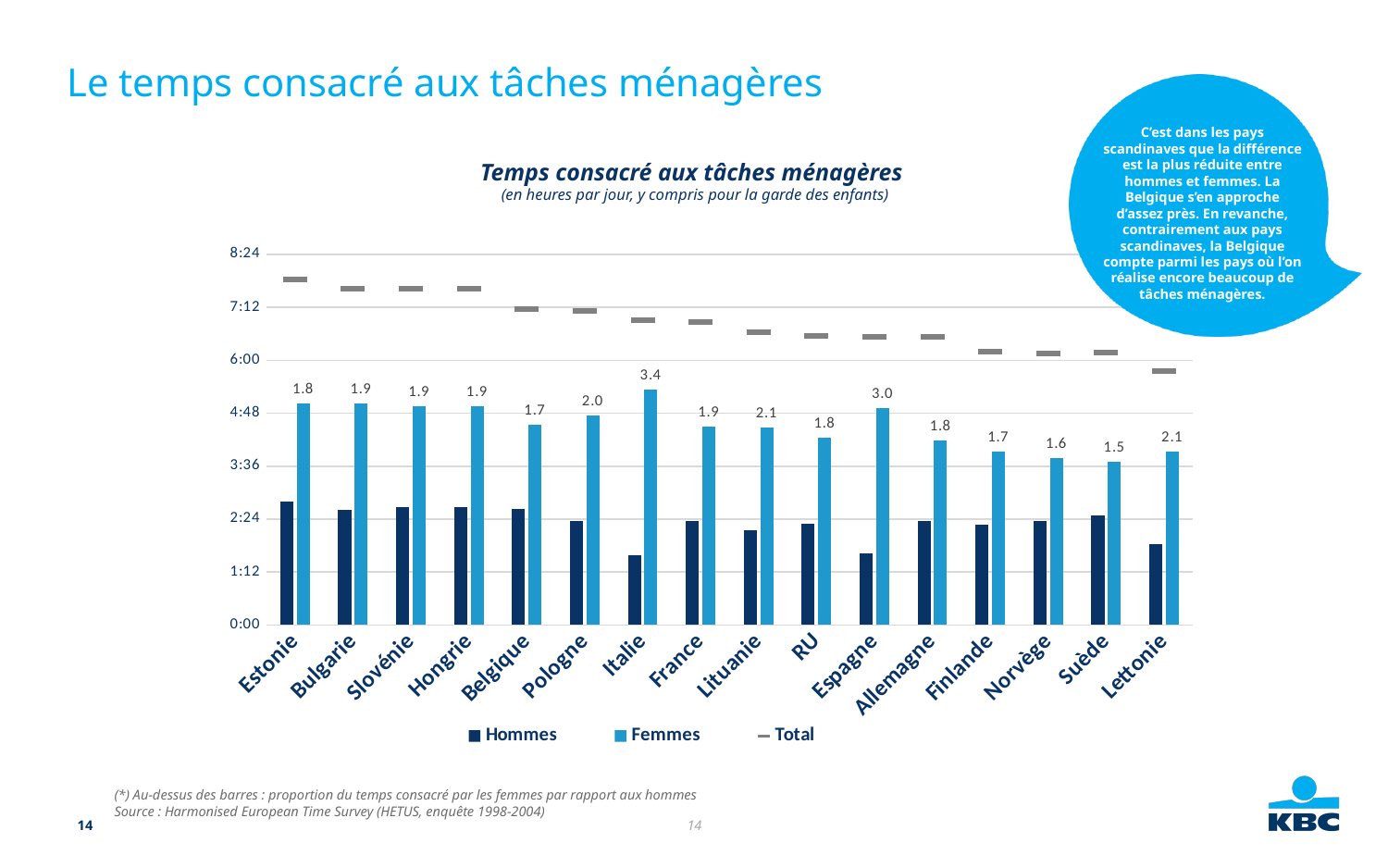
Which country has the highest ratio label above its bars? Italie Does the Total series rise or fall from left to right across the countries? fall How many countries are shown on the x axis? 16 What is the data label shown above the bars for Suède? 1.5 Is the Hommes value for Italie greater or less than 2:24? less Is the Femmes value for Italie greater or less than 4:48? greater What is the data label shown above the bars for Italie? 3.4 Which country has the lowest ratio label above its bars? Suède Is the Total value for Lettonie greater or less than 6:00? less How many series does the legend list? 3 What is the data label shown above the bars for Espagne? 3.0 What is the difference between the ratio labels for Italie and Suède? 1.9